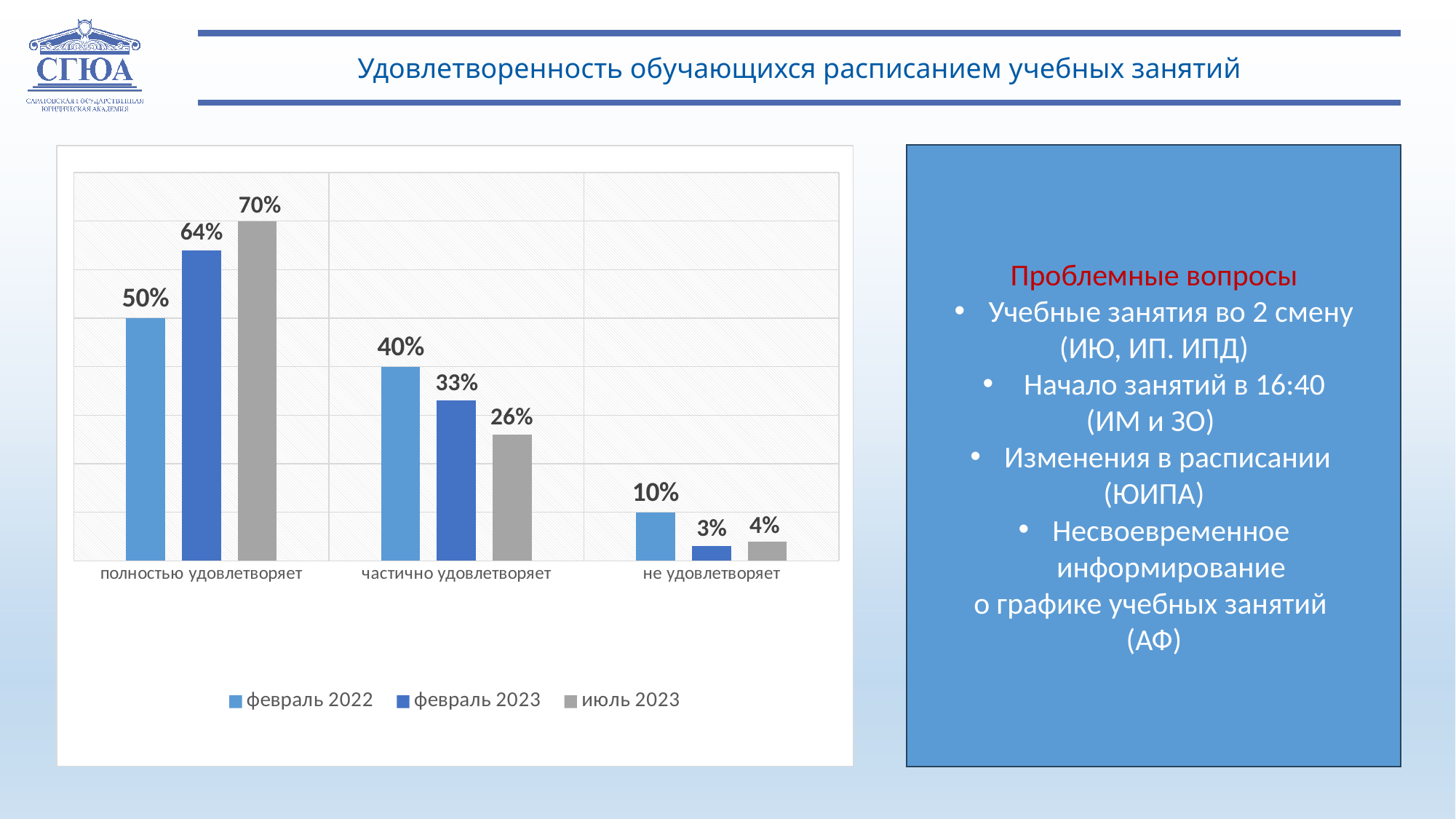
What is the value for 'полностью удовлетворяет' in the 'февраль 2023' series? 64% What is the value for 'частично удовлетворяет' in the 'февраль 2022' series? 40% Which category has the highest value in the 'июль 2023' series? полностью удовлетворяет What is the difference between the 'июль 2023' and 'февраль 2022' values for 'полностью удовлетворяет'? 20% How many series does the legend list? 3 Which series is shown in grey in the legend? июль 2023 Which is larger for 'частично удовлетворяет': the 'февраль 2023' value or the 'июль 2023' value? февраль 2023 What is the value for 'не удовлетворяет' in the 'февраль 2023' series? 3% How many categories are shown on the x axis? 3 Which category has the lowest value in the 'февраль 2022' series? не удовлетворяет What is the value for 'полностью удовлетворяет' in the 'июль 2023' series? 70% What kind of chart is shown on the slide? bar chart